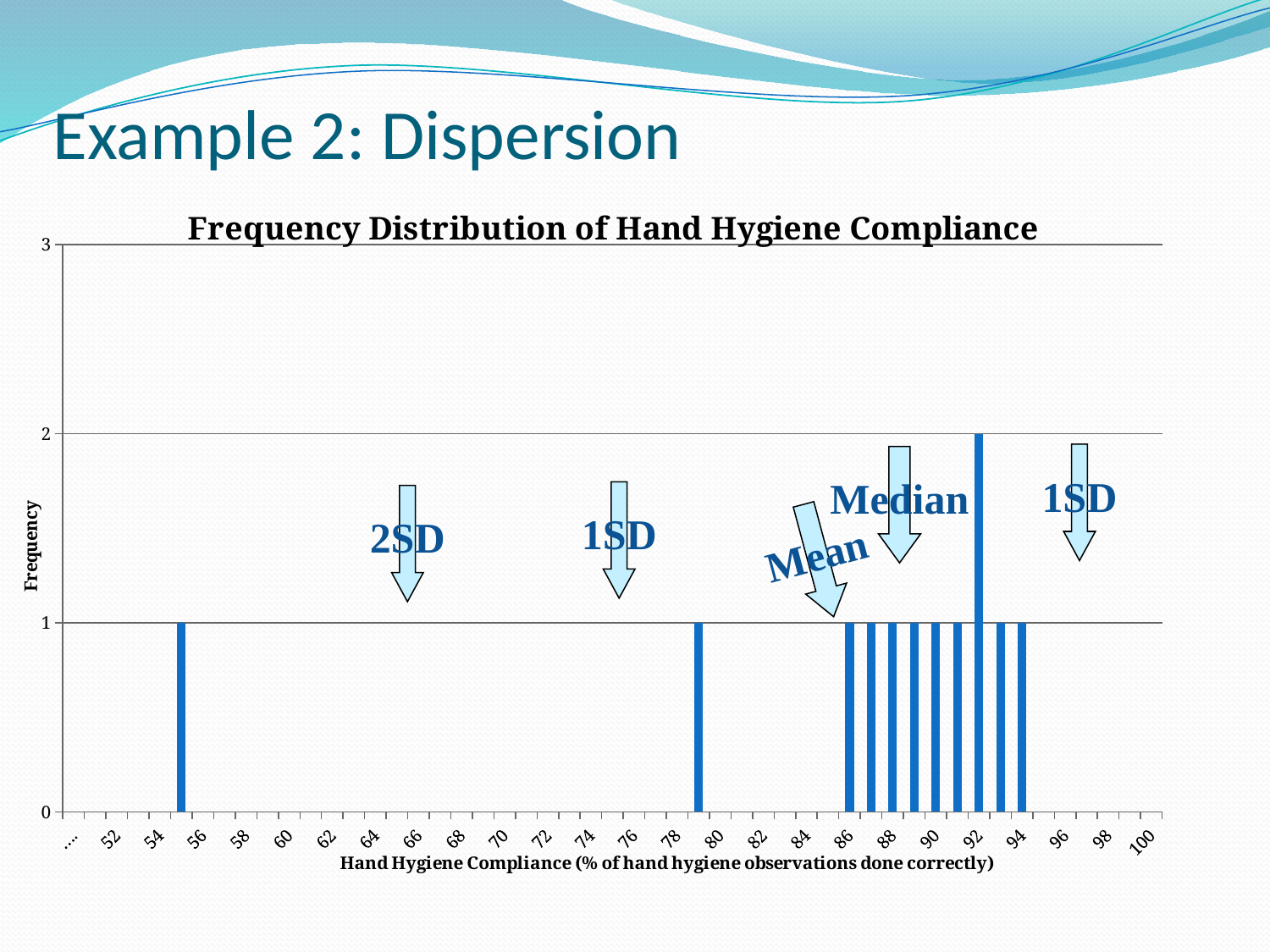
What is the difference between the frequency at 92 and the frequency at 90? 1 What is the highest value shown on the vertical axis? 3 What is the frequency for a hand hygiene compliance of 86? 1 Is the frequency for a compliance of 92 greater or less than 1? greater What is the label of the vertical axis? Frequency Which hand hygiene compliance value has the highest frequency? 92 What is the frequency for a hand hygiene compliance of 94? 1 What is the frequency for a hand hygiene compliance of 60? 0 What is the title of the chart? Frequency Distribution of Hand Hygiene Compliance What is the frequency for a hand hygiene compliance of 92? 2 What kind of chart is shown on the slide? bar chart Which has the higher frequency, a compliance of 92 or a compliance of 88? 92